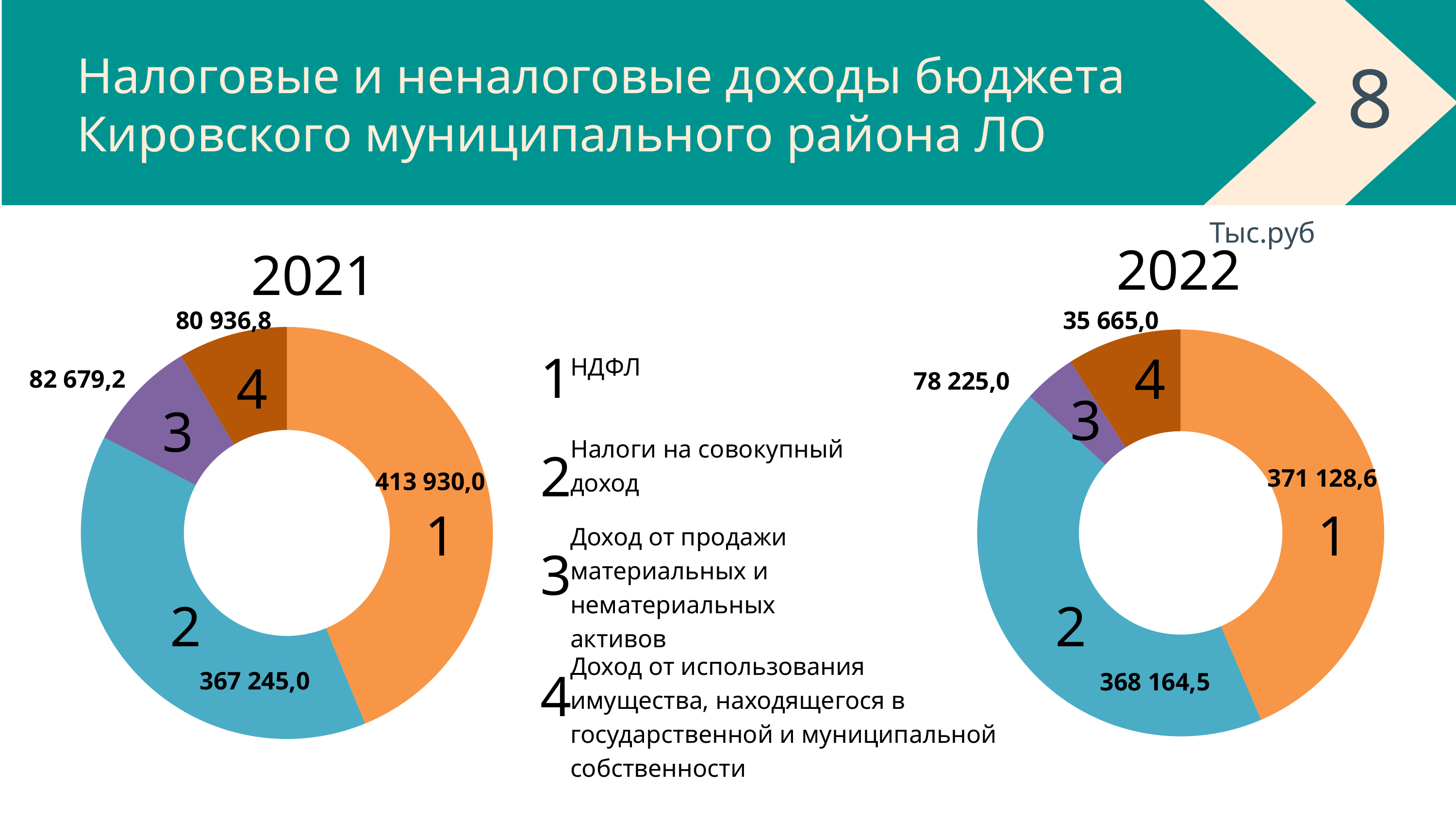
In the 2022 chart, what is the value for segment 2 (Налоги на совокупный доход)? 368 164,5 In the 2022 chart, what is the difference between segment 3 and segment 4? 42 560,0 In the 2021 chart, what is the value for segment 1 (НДФЛ)? 413 930,0 How many segments does the 2022 chart have? 4 Is the value for segment 3 larger in the 2021 chart or the 2022 chart? 2021 In the 2021 chart, what is the difference between segment 1 and segment 2? 46 685,0 In the 2021 chart, which segment has the largest value? 1 (НДФЛ) In the 2022 chart, what is the value for segment 4 (Доход от использования имущества)? 35 665,0 What kind of chart is used for 2021 and 2022? Donut (pie) chart In the 2021 chart, what is the value for segment 3 (Доход от продажи материальных и нематериальных активов)? 82 679,2 What unit is indicated for the values on the slide? Тыс.руб